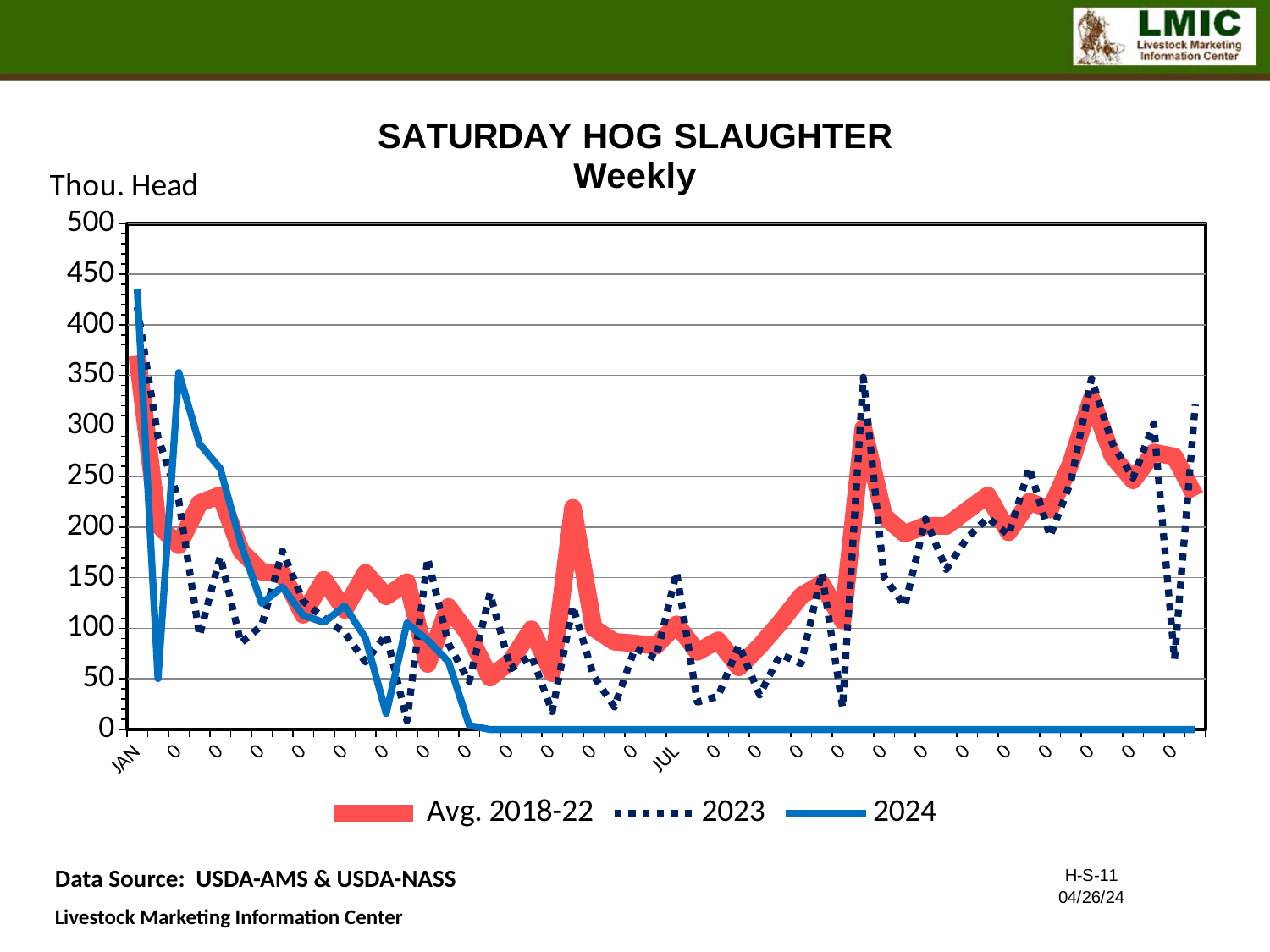
At JAN, which series has the higher value, 2024 or Avg. 2018-22? 2024 Is the value for the 2023 series at JUL greater or less than 200? less What data source is cited below the chart? USDA-AMS & USDA-NASS What are the three series named in the legend? Avg. 2018-22, 2023, 2024 Is the lowest value of the 2024 series in the first few weeks greater or less than 100? less How many series does the legend list? 3 Does the 2024 line generally rise or fall from JAN to where it ends? fall What kind of chart is shown on the slide? line chart Is the value for the 2024 series at JAN greater or less than 400? greater